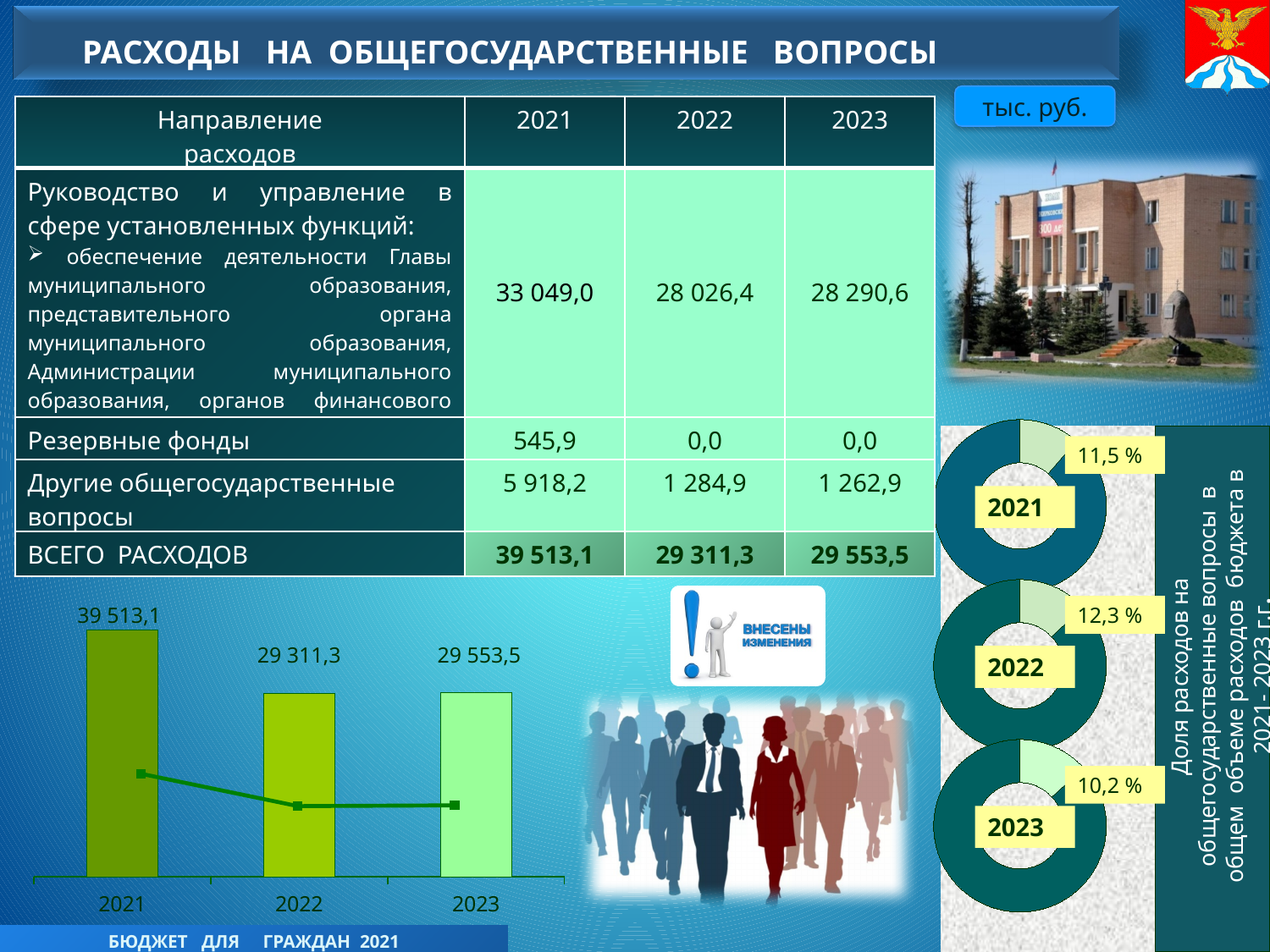
In the donut charts on the right, which year has the lowest share? 2023 In the bar chart at the bottom left, what is the difference between the 2023 and 2022 values? 242,2 In the bar chart at the bottom left, what is the value for 2023? 29 553,5 In the bar chart at the bottom left, what is the value for 2022? 29 311,3 In the bar chart at the bottom left, which year has the lowest value? 2022 In the bar chart at the bottom left, what is the difference between the 2021 and 2022 values? 10 201,8 In the bar chart at the bottom left, how many years are shown on the x axis? 3 In the bar chart at the bottom left, which year has the highest value? 2021 In the donut charts on the right, what share is shown for 2022? 12,3 % What kind of chart is shown at the bottom left of the slide? bar chart In the bar chart at the bottom left, what is the value for 2021? 39 513,1 In the donut charts on the right, what is the difference between the 2022 and 2023 shares? 2,1 %